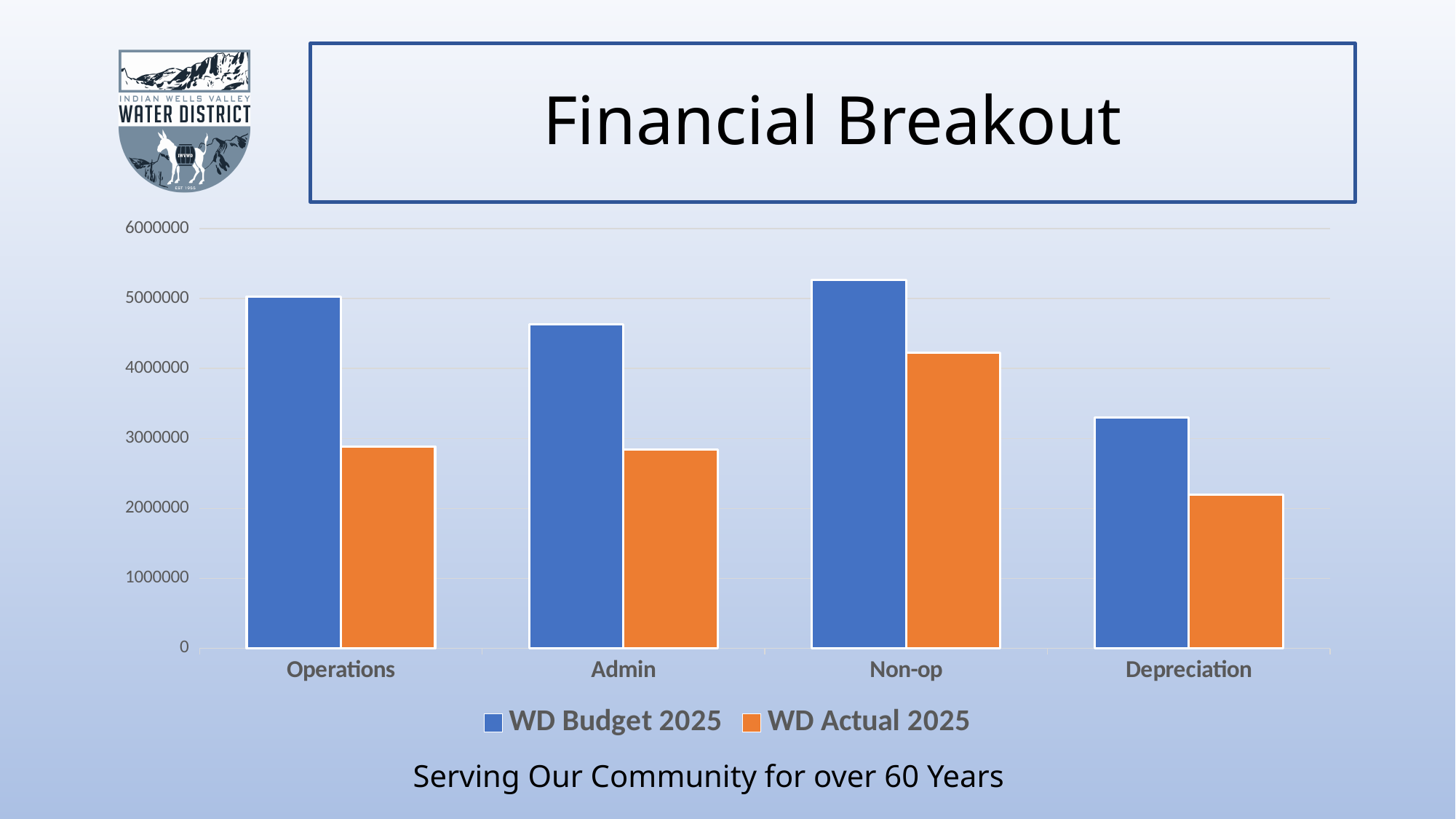
For Operations, which is larger: WD Budget 2025 or WD Actual 2025? WD Budget 2025 What kind of chart is shown on the slide? bar chart Which category has the highest WD Budget 2025 value? Non-op How many categories are shown on the x axis? 4 What is the title of the slide containing the chart? Financial Breakout Is the WD Actual 2025 value for Depreciation greater or less than 3000000? less Which category has the lowest WD Actual 2025 value? Depreciation How many series does the legend list? 2 Which category has the lowest WD Budget 2025 value? Depreciation Which category has the highest WD Actual 2025 value? Non-op Which is larger: the WD Actual 2025 value for Non-op or the WD Budget 2025 value for Depreciation? WD Actual 2025 for Non-op Is the WD Budget 2025 value for Non-op greater or less than 5000000? greater